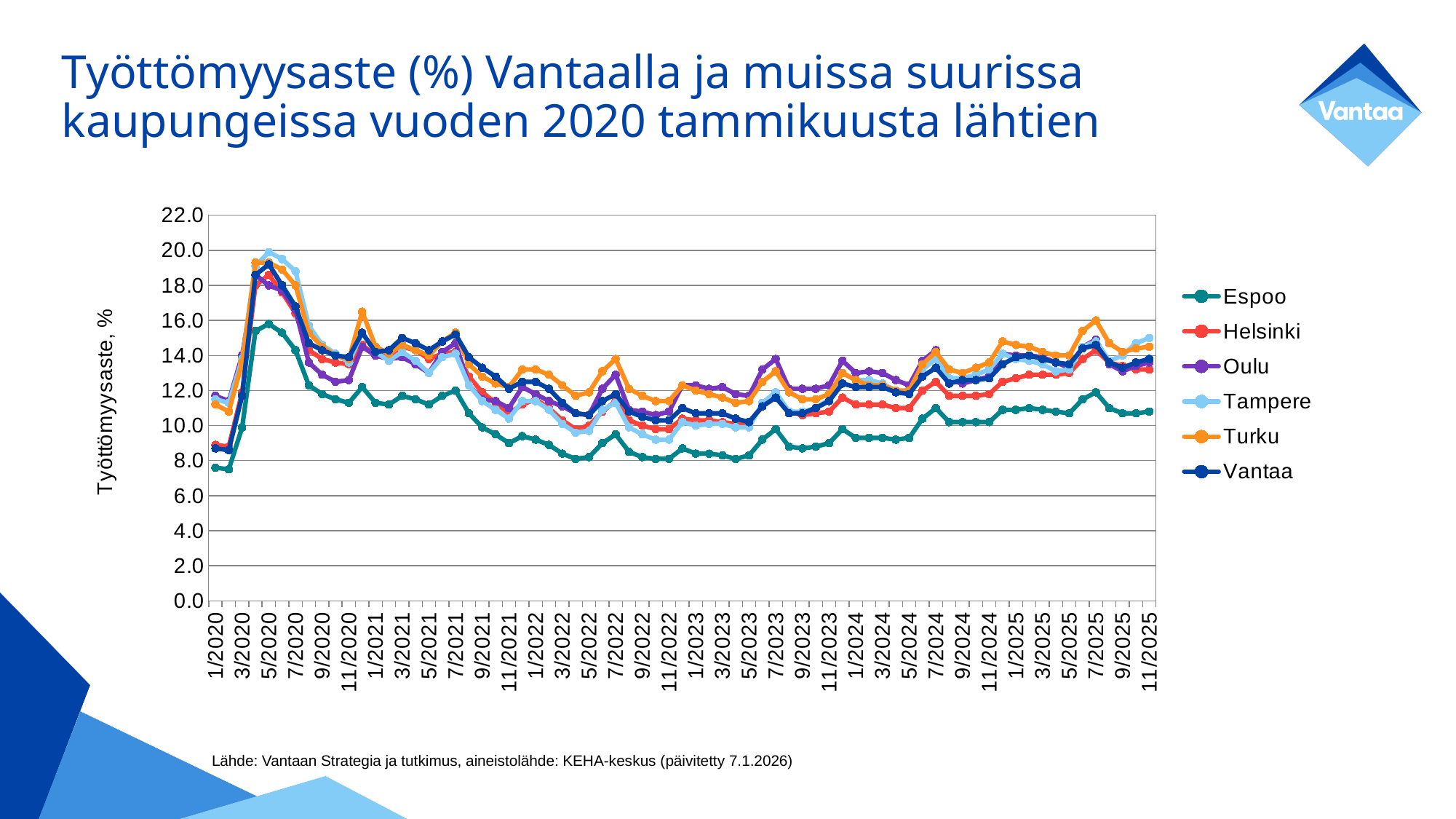
Do the unemployment rates rise or fall between 1/2020 and 5/2020? rise Which city has the lowest unemployment rate at 11/2025? Espoo Which cities are listed in the chart legend? Espoo, Helsinki, Oulu, Tampere, Turku, Vantaa How many series does the legend list? 6 Is the value for Vantaa at 1/2020 greater or less than 10.0? less Is the value for Vantaa at 11/2025 greater or less than 12.0? greater What kind of chart is shown on the slide? Line chart Is the value for Espoo at 9/2022 greater or less than 10.0? less Which city has the highest unemployment rate at 7/2022? Turku Which is larger at 11/2025, the value for Vantaa or the value for Espoo? Vantaa What is the label of the vertical axis? Työttömyysaste, %